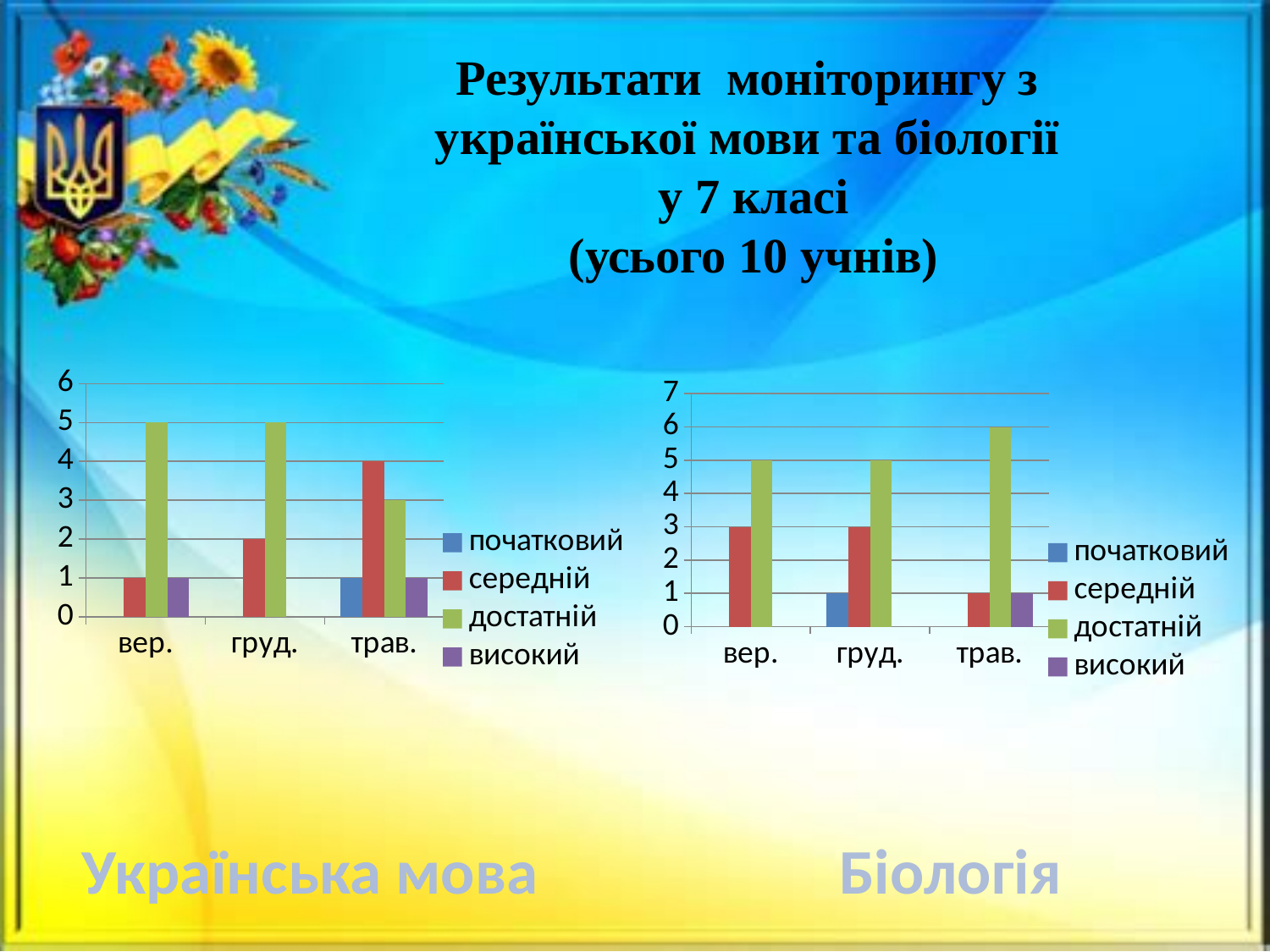
How many months are shown on the x axis of the Українська мова chart? 3 On the Українська мова chart, which colour represents достатній? green On the Українська мова chart, what is the difference between достатній and середній for груд.? 3 How many series does the legend of the Біологія chart list? 4 On the Українська мова chart, in which month is середній highest? трав. On the Українська мова chart, what is the value of достатній for вер.? 5 What type of chart is the Біологія chart? bar chart On the Біологія chart, which is larger for трав.: достатній or середній? достатній On the Українська мова chart, what is the value of середній for трав.? 4 On the Біологія chart, what is the value of достатній for трав.? 6 On the Біологія chart, in which month is достатній highest? трав. On the Біологія chart, what is the value of середній for вер.? 3